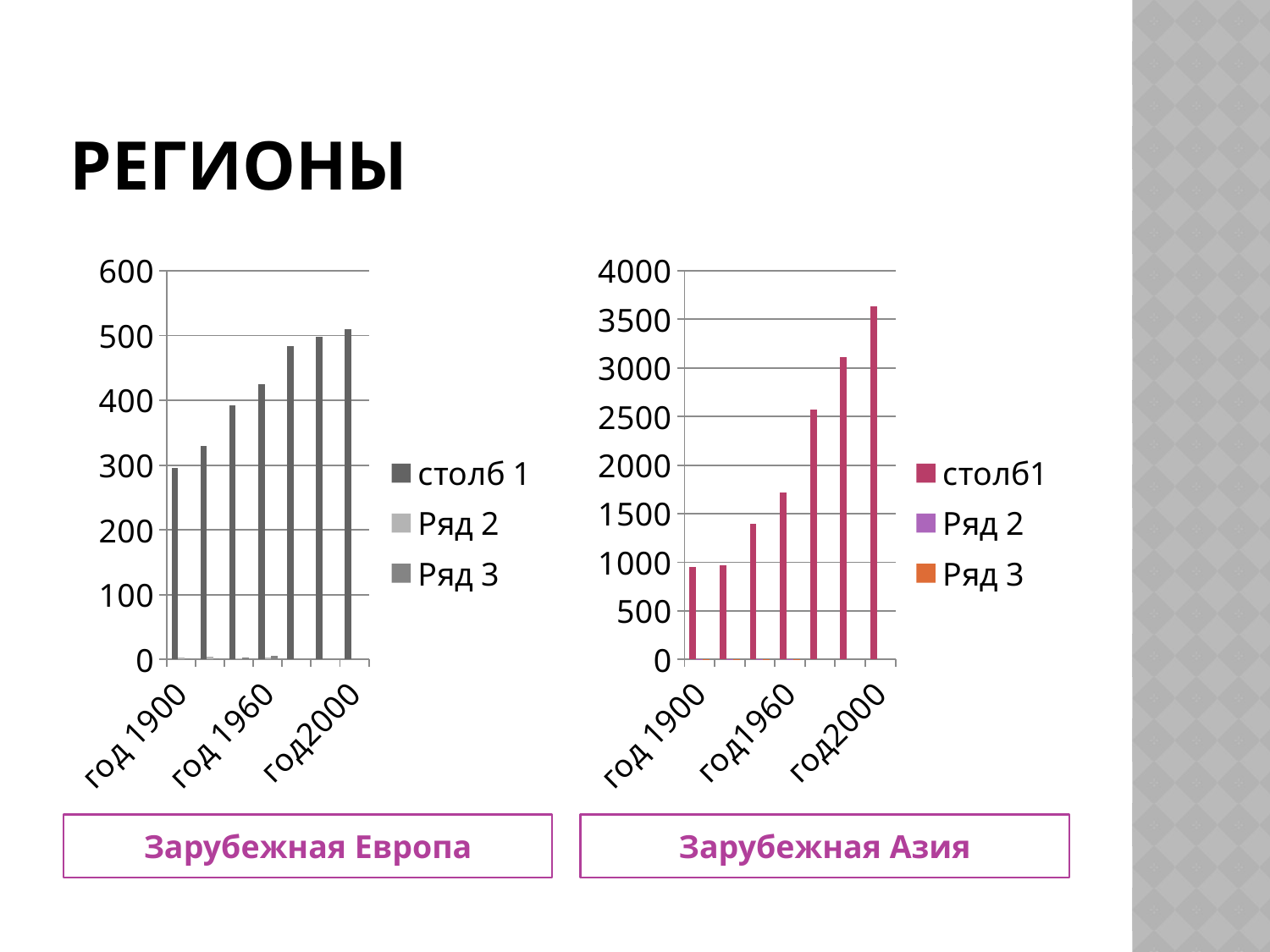
What are the three legend entries of the "Зарубежная Азия" chart? столб1, Ряд 2, Ряд 3 In the "Зарубежная Азия" chart, is the value for год2000 greater or less than 3000? greater In the "Зарубежная Азия" chart, which labelled category has the highest value? год2000 In the "Зарубежная Европа" chart, how many series does the legend list? 3 In the "Зарубежная Европа" chart, is the value for год 1900 greater or less than 400? less In the "Зарубежная Европа" chart, is the value for год2000 greater or less than 400? greater In the "Зарубежная Европа" chart, do the bar values rise or fall from left to right along the x axis? rise In the "Зарубежная Европа" chart, which is larger, the value for год 1900 or the value for год2000? год2000 In the "Зарубежная Азия" chart, do the bar values rise or fall from left to right along the x axis? rise What type of chart is shown under the caption "Зарубежная Европа"? bar chart